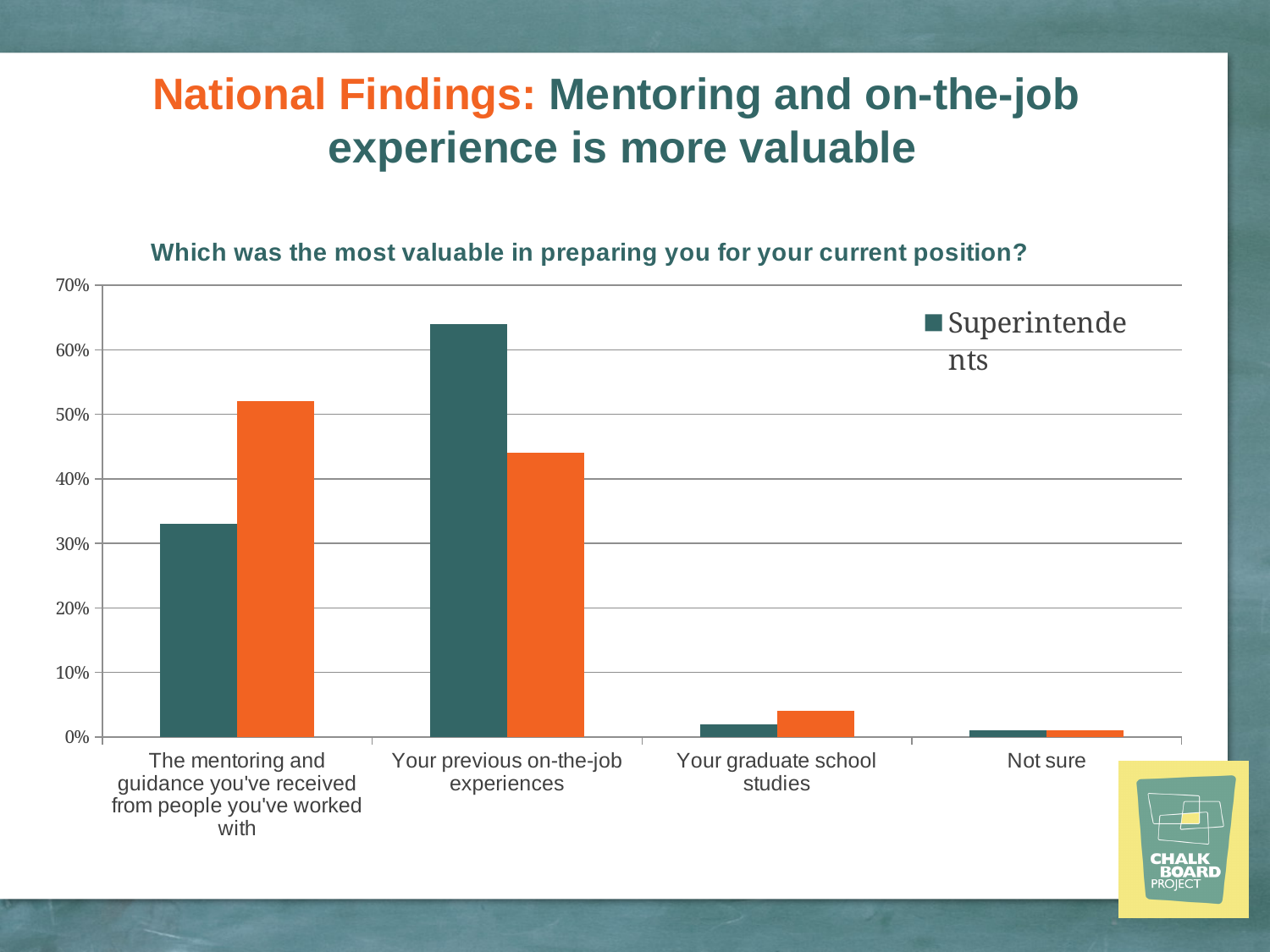
Is the Superintendents value for 'The mentoring and guidance you've received from people you've worked with' greater or less than 40%? less Is the orange bar for 'Your previous on-the-job experiences' greater or less than 50%? less Is the Superintendents value for 'Your graduate school studies' greater or less than 10%? less How many categories are shown along the x axis of the chart? 4 Which category has the highest Superintendents (teal) bar? Your previous on-the-job experiences What is the title of the chart? Which was the most valuable in preparing you for your current position? What kind of chart is shown on the slide? Bar chart For Superintendents, which is larger: 'The mentoring and guidance you've received from people you've worked with' or 'Your previous on-the-job experiences'? Your previous on-the-job experiences Which category has the lowest Superintendents (teal) bar? Not sure Which series name is readable in the chart legend? Superintendents